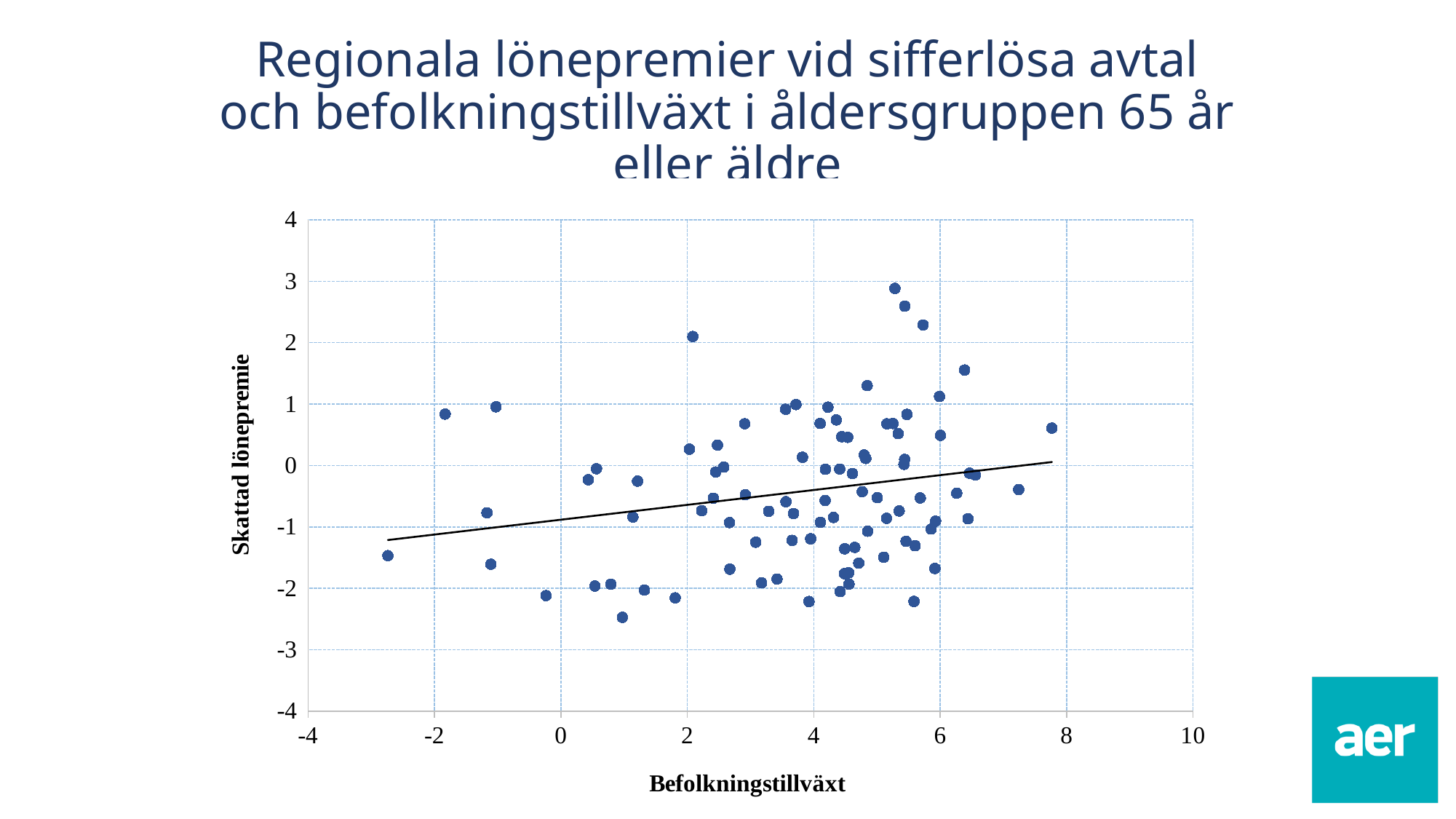
Is the Skattad lönepremie of the leftmost point in the chart greater or less than -1? less What kind of chart is shown on the slide? Scatter plot What is the title of the y axis? Skattad lönepremie Is the Skattad lönepremie of the lowest point in the chart greater or less than -2? less Does the fitted trend line rise or fall as Befolkningstillväxt increases? Rises What is the title of the x axis? Befolkningstillväxt Is the Befolkningstillväxt of the rightmost point in the chart greater or less than 6? greater